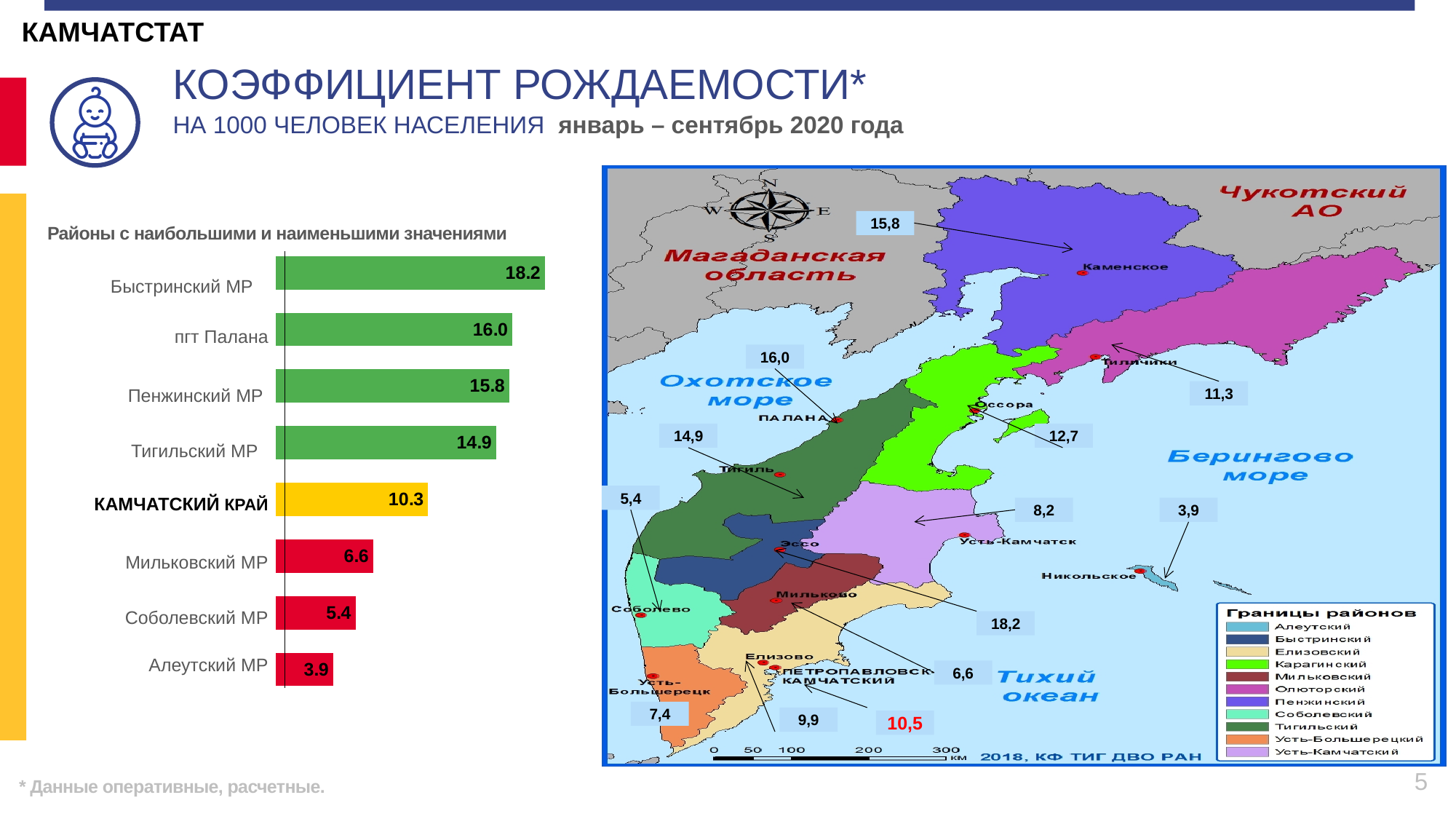
By how much does the value for Пенжинский МР exceed the value for Тигильский МР in the bar chart? 0.9 How many categories are shown in the bar chart? 8 Which is larger in the bar chart: the value for Мильковский МР or the value for Соболевский МР? Мильковский МР Which district has the highest value in the bar chart? Быстринский МР What value does the bar chart show for пгт Палана? 16.0 What value is shown for Соболевский МР in the bar chart? 5.4 What type of chart is used to show the districts with the highest and lowest values? Bar chart What is the value for КАМЧАТСКИЙ КРАЙ in the bar chart? 10.3 What colour is the bar for КАМЧАТСКИЙ КРАЙ in the bar chart? Yellow What is the birth rate value shown for Быстринский МР in the bar chart? 18.2 What is the difference between the values for Быстринский МР and Алеутский МР in the bar chart? 14.3 Which district has the lowest value in the bar chart? Алеутский МР